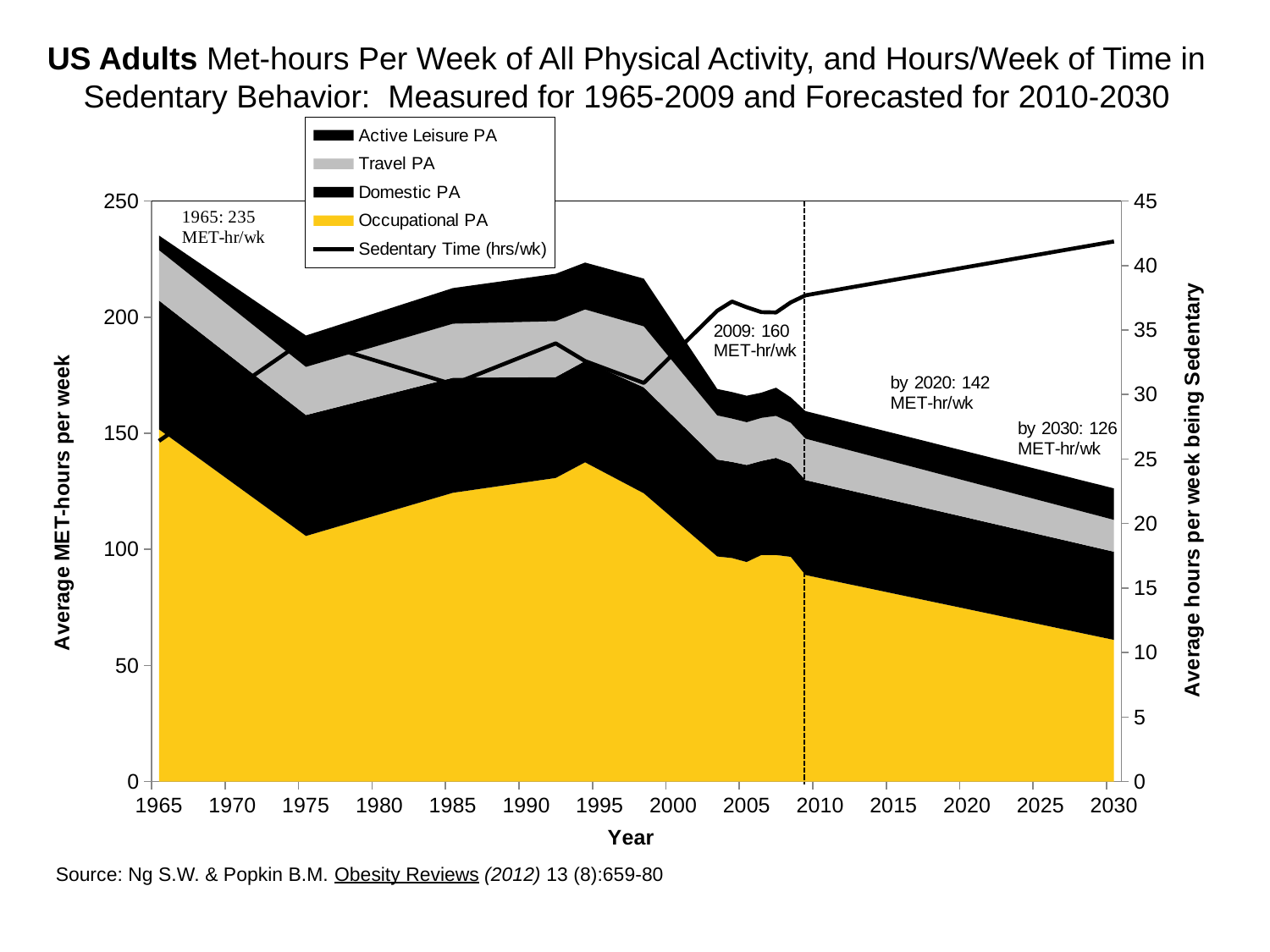
What is the annotated total MET-hours per week value for 2009? 160 MET-hr/wk What kind of chart is this? Stacked area chart with a line What is the difference between the annotated 2009 value and the forecast 2020 value? 18 MET-hr/wk Which is larger, the annotated total for 2009 or the forecast for 2020? 2009 By how many MET-hr/wk does the annotated total fall from 1965 to 2030? 109 MET-hr/wk Is the Occupational PA value in 2030 greater or less than 100 MET-hours per week? less How many series does the legend list? 5 Which colour represents Occupational PA in the chart? Yellow What is the total MET-hours per week of physical activity for US adults in 1965, as annotated on the chart? 235 MET-hr/wk Of the four annotated years (1965, 2009, 2020, 2030), which has the highest total MET-hours per week? 1965 What total MET-hours per week is forecast for 2030? 126 MET-hr/wk Does the Sedentary Time line rise or fall from 2009 to 2030? Rises